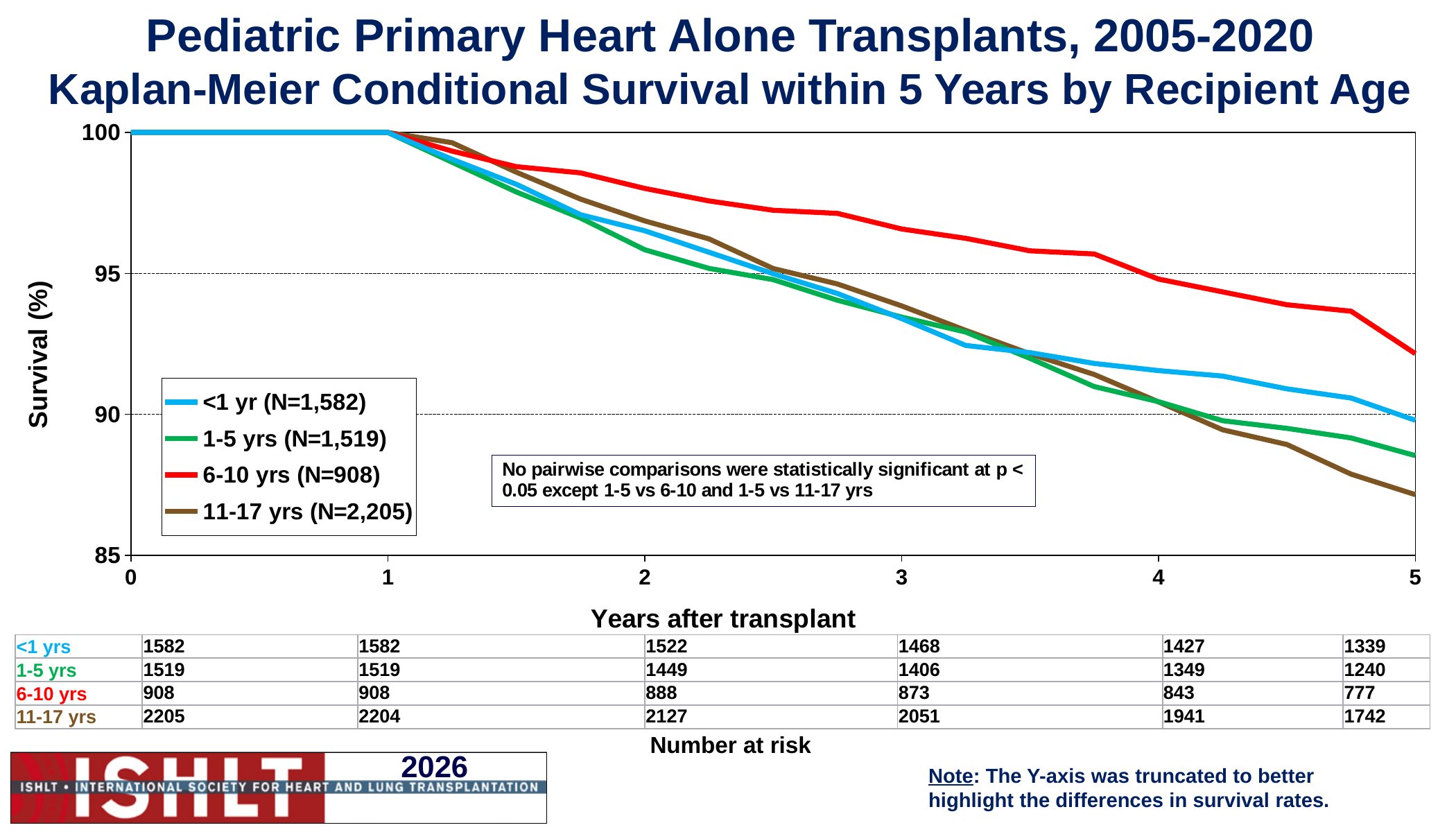
What kind of chart is shown on the slide? line chart What is the number at risk for the 11-17 yrs group at year 5? 1742 At 4 years after transplant, which group has higher survival, <1 yr or 1-5 yrs? <1 yr Do the survival curves rise or fall as years after transplant increase? fall What is the title of the x axis? Years after transplant Which recipient age group has the lowest survival at 5 years after transplant? 11-17 yrs Is the survival for the 6-10 yrs group at 3 years greater or less than 95? greater What is the difference between the number at risk for the <1 yrs group at year 0 and at year 5? 243 Is the survival for the 11-17 yrs group at 5 years greater or less than 90? less Which recipient age group has the highest survival at 5 years after transplant? 6-10 yrs According to the legend, what is the N for the 6-10 yrs group? N=908 How many series does the legend list? 4